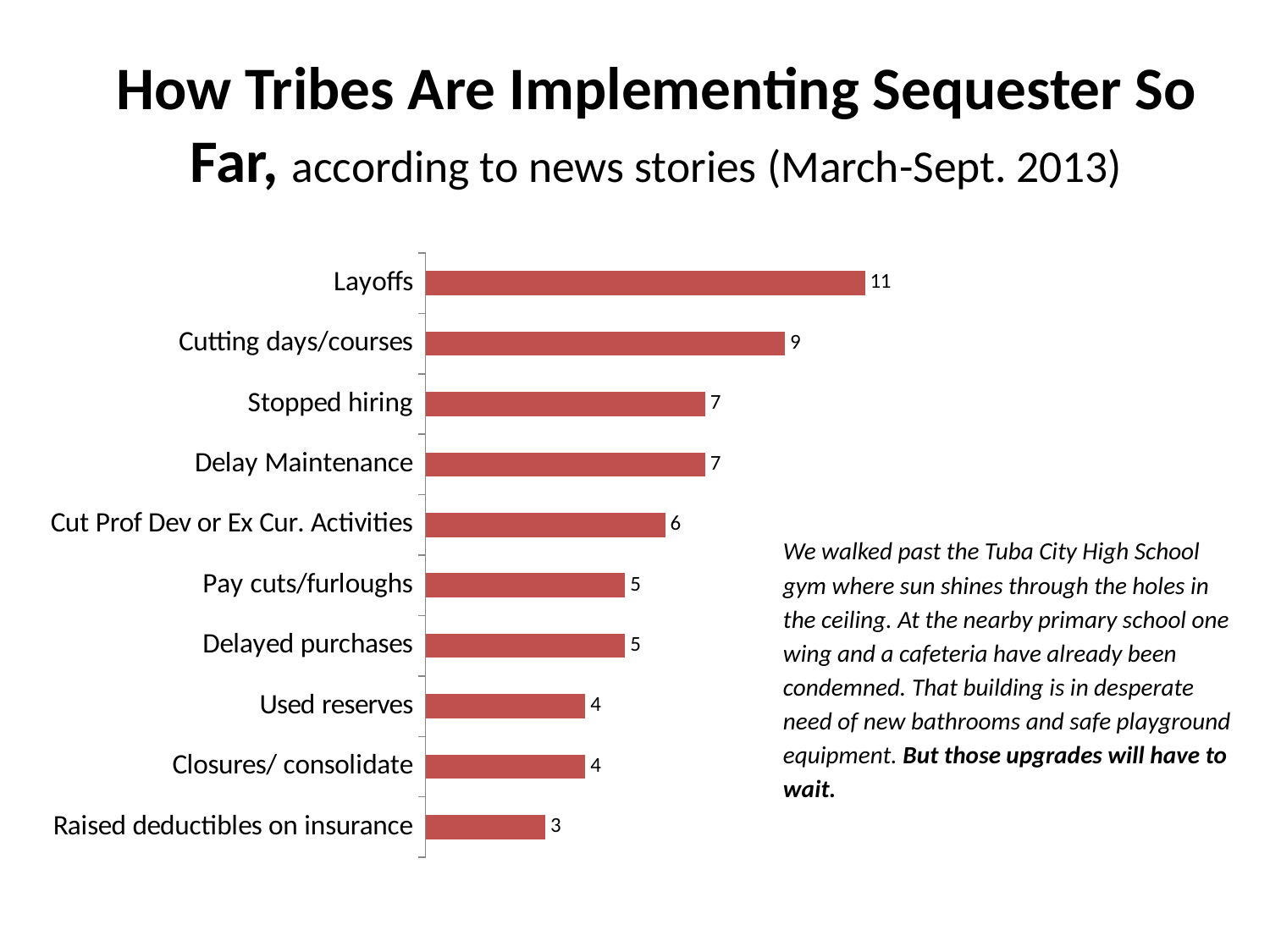
What kind of chart is shown on the slide? Bar chart What is the value for Cutting days/courses? 9 What is the value for Layoffs? 11 How many categories are shown in the chart? 10 What is the difference between the values for Layoffs and Cutting days/courses? 2 Which is larger, the value for Pay cuts/furloughs or the value for Closures/ consolidate? Pay cuts/furloughs Which category has the highest value? Layoffs Which category has the lowest value? Raised deductibles on insurance What is the difference between the values for Stopped hiring and Used reserves? 3 What is the value for Raised deductibles on insurance? 3 What is the value for Cut Prof Dev or Ex Cur. Activities? 6 What colour are the bars in the chart? Red